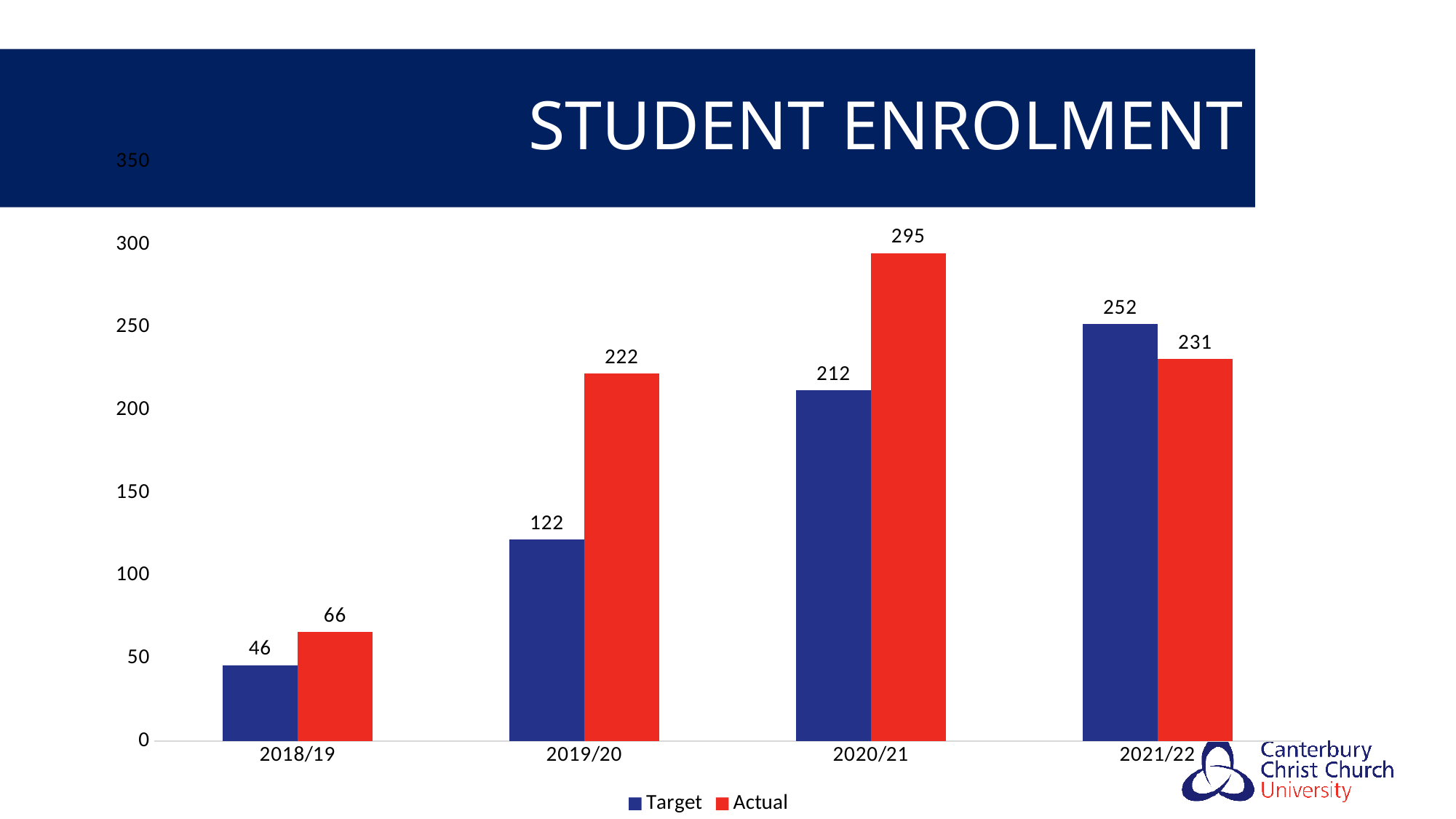
What is the Target value for 2019/20? 122 What is the Actual value for 2020/21? 295 How many years are shown on the x axis? 4 Which year has the lowest Target value? 2018/19 Is the Actual value for 2019/20 greater or less than 200? greater Which year has the highest Actual value? 2020/21 What is the difference between the Actual and Target values for 2020/21? 83 Which is larger for 2021/22, Target or Actual? Target What kind of chart is shown? Bar chart Does the Target value rise or fall from 2018/19 to 2021/22? Rise What is the Actual value for 2018/19? 66 How many series does the legend list? 2